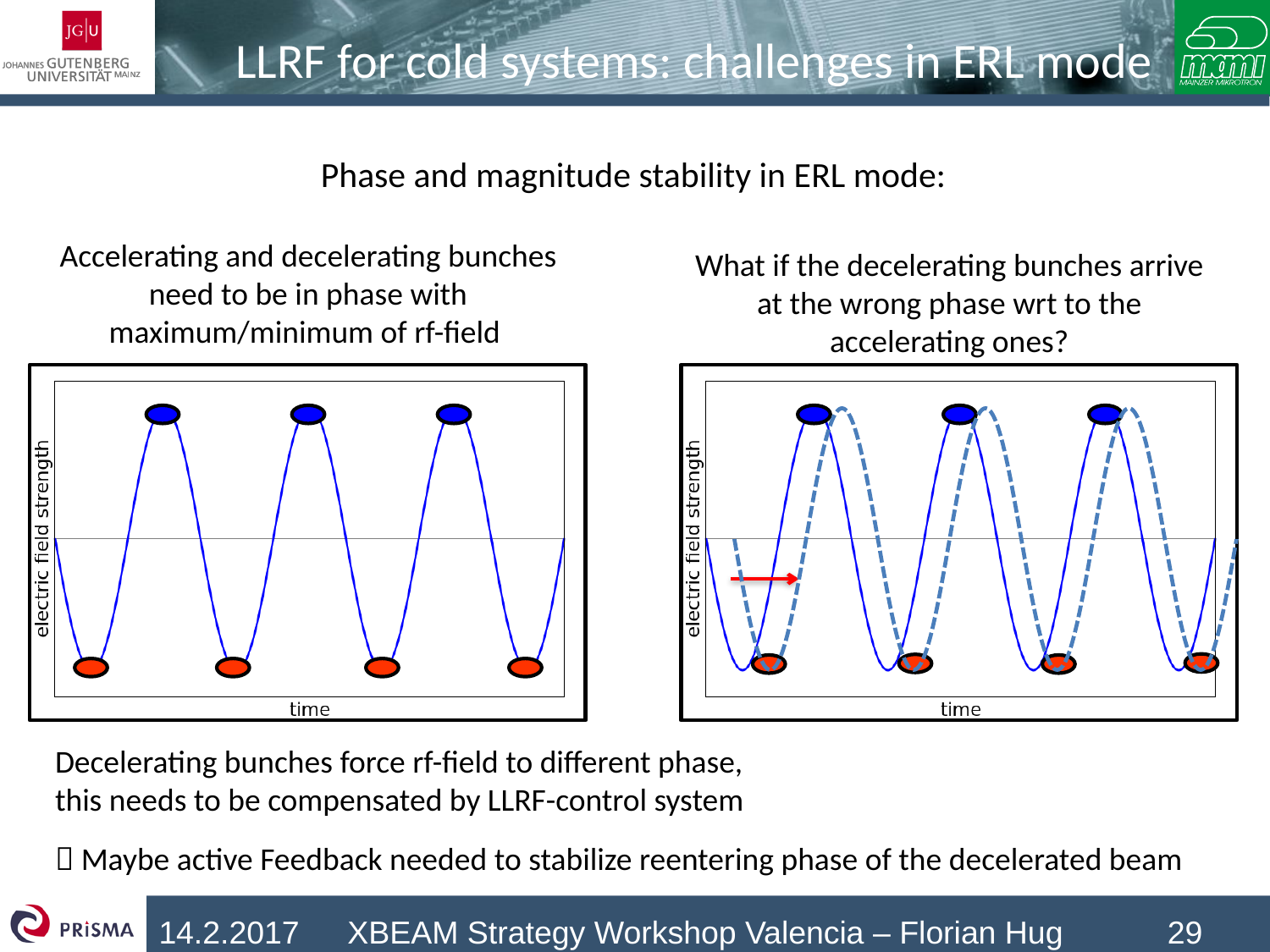
In the left chart, how many red bunches are drawn at the minima of the rf-field? 4 What kind of chart is the left chart on the slide? line chart What is the y-axis label of the left chart? electric field strength In the left chart, how many blue bunches are drawn at the maxima of the rf-field? 3 In the left chart, are the blue bunches located at the maxima or the minima of the field curve? maxima In the right chart, how many curves are plotted (solid and dashed)? 2 In the right chart, how many red bunches are drawn? 4 What is the x-axis label of the right chart? time In the right chart, is the dashed curve shifted to the right or to the left of the solid blue curve? to the right